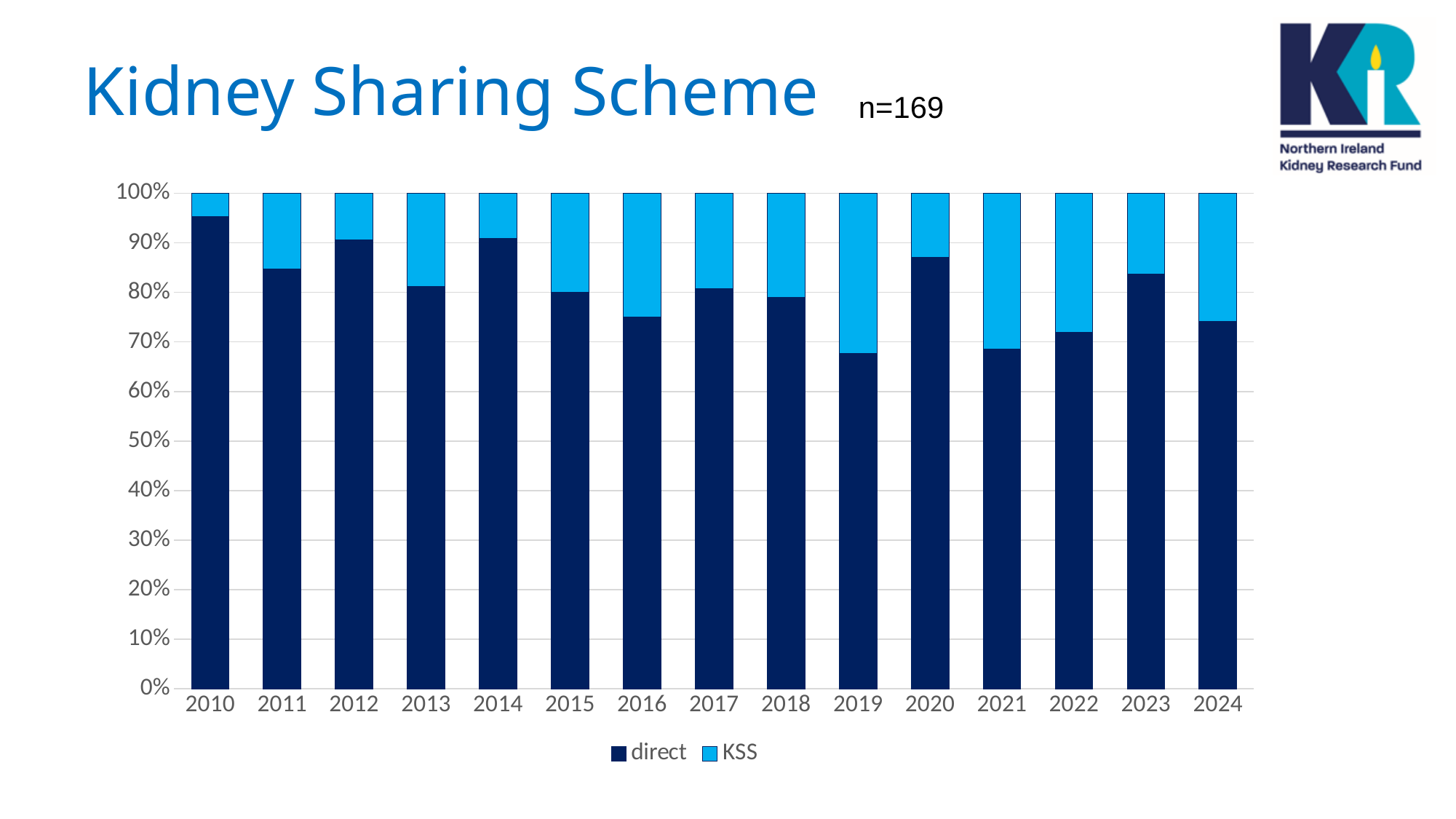
In which year is the direct share the highest? 2010 What is the total of the stacked bar for 2015? 100% What kind of chart is shown on the slide? stacked bar chart How many series does the chart's legend list? 2 In which year is the KSS share the lowest? 2010 Is the direct value for 2019 greater or less than 70%? less What are the two series named in the legend? direct and KSS What is the title of the slide containing the chart? Kidney Sharing Scheme How many years are shown on the x axis of the chart? 15 Is the direct value for 2016 greater or less than 70%? greater Is the direct value for 2020 greater or less than 80%? greater Which year has a larger direct share, 2010 or 2016? 2010